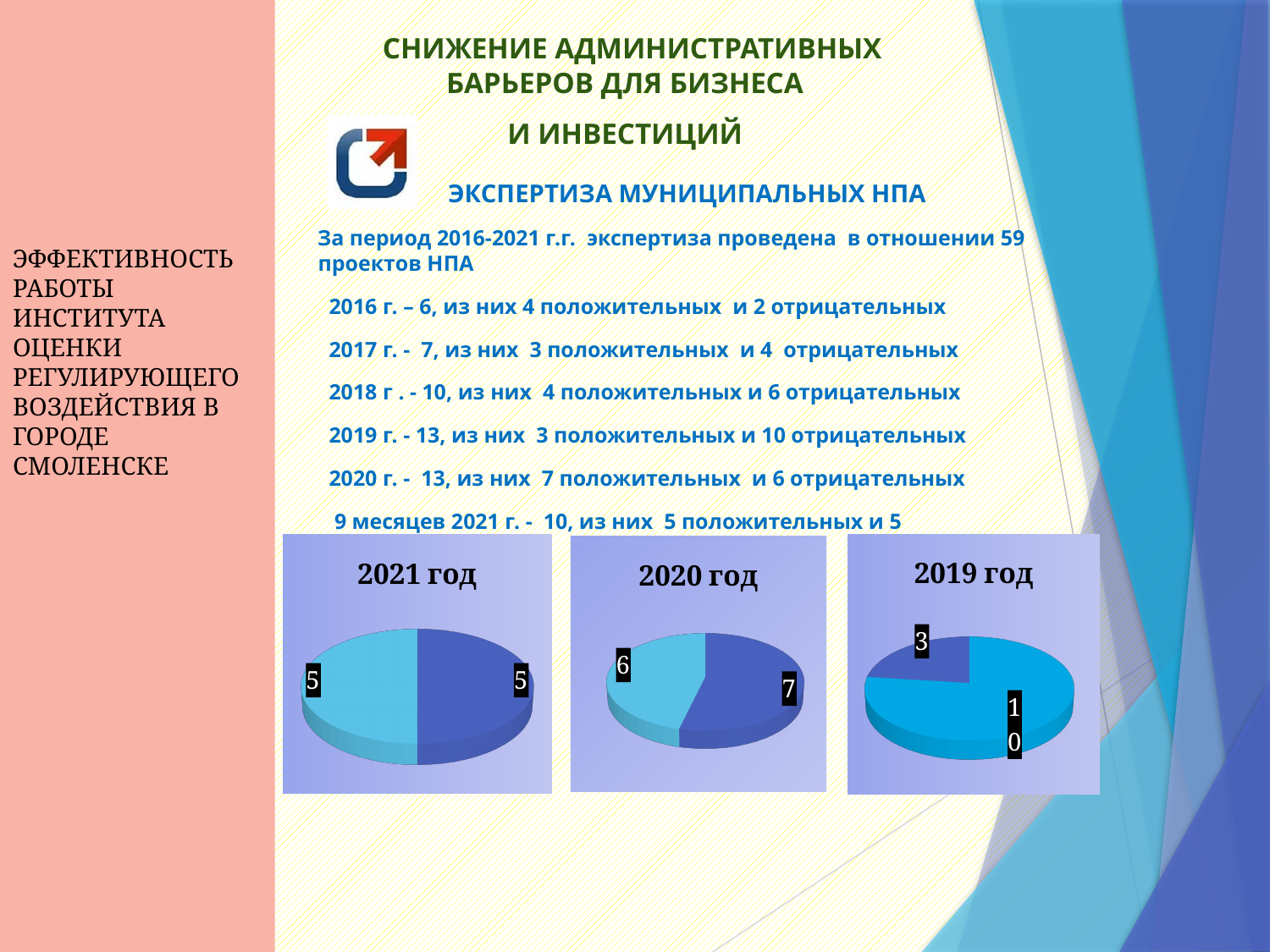
In the 2020 год chart, what is the value of the smaller slice? 6 In the 2020 год chart, what is the value of the larger slice? 7 In the 2021 год chart, how many slices does the pie have? 2 In the 2021 год chart, what is the total of the two slices? 10 How many pie charts are shown on the slide? 3 In the 2019 год chart, what is the value of the largest slice? 10 In the 2019 год chart, what is the total of the two slices? 13 What kind of chart is used for the 2021 год, 2020 год and 2019 год charts? Pie chart In the 2019 год chart, which slice is dark blue: the one labelled 3 or the one labelled 10? The one labelled 3 In the 2021 год chart, what is the value of each slice? 5 In the 2020 год chart, what is the difference between the two slice values? 1 In the 2021 год chart, what share of the pie does each slice represent? 50%